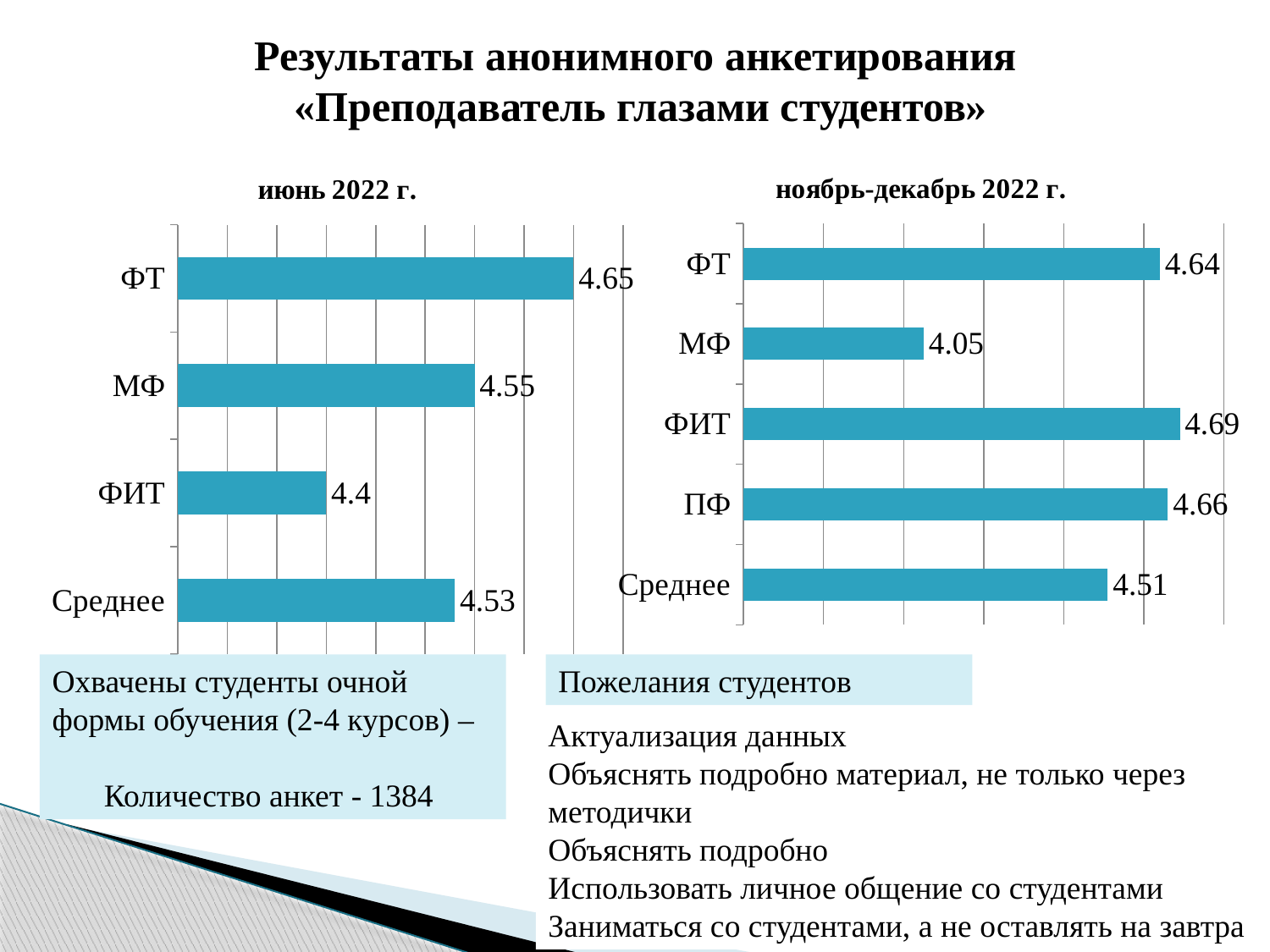
In the chart titled "ноябрь-декабрь 2022 г.", what is the value for МФ? 4.05 In the chart titled "июнь 2022 г.", what is the difference between the values for ФТ and МФ? 0.1 In the chart titled "июнь 2022 г.", what is the value for ФИТ? 4.4 In the chart titled "ноябрь-декабрь 2022 г.", which category has the lowest value? МФ In the chart titled "ноябрь-декабрь 2022 г.", which is larger, the value for ФТ or the value for МФ? ФТ In the chart titled "ноябрь-декабрь 2022 г.", how many categories are shown? 5 In the chart titled "ноябрь-декабрь 2022 г.", what is the value for ПФ? 4.66 In the chart titled "июнь 2022 г.", what is the value for ФТ? 4.65 In the chart titled "ноябрь-декабрь 2022 г.", which category has the highest value? ФИТ What kind of chart is the chart titled "июнь 2022 г."? Bar chart In the chart titled "июнь 2022 г.", how many categories are shown? 4 In the chart titled "июнь 2022 г.", which category has the lowest value? ФИТ